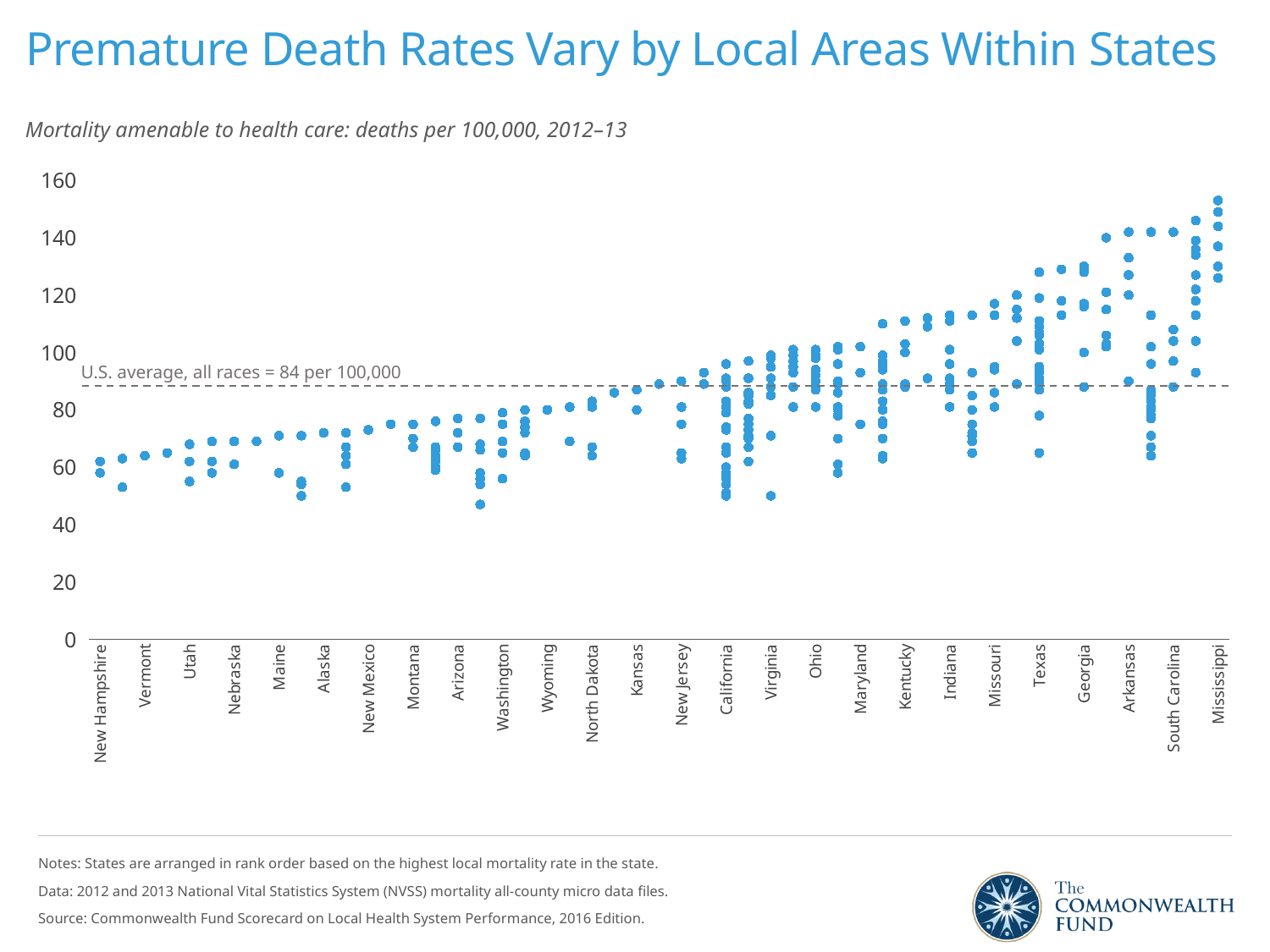
Are all of the New Hampshire points greater or less than 80? less What is the maximum value shown on the y axis of the chart? 160 Is the highest value for Mississippi greater or less than 140? greater How many states are listed along the x axis of the chart? 26 What is the U.S. average mortality rate, all races, shown by the dashed line on the chart? 84 per 100,000 Which state is listed first (leftmost) on the x axis? New Hampshire What kind of chart is shown on the slide? Scatter (dot) plot According to the notes, how are the states arranged on the chart? In rank order based on the highest local mortality rate in the state Which state has the larger highest local value, Georgia or Mississippi? Mississippi Do the highest local mortality rates generally rise or fall moving from left to right along the x axis? rise Which state has the highest local mortality rate on the chart? Mississippi Is the highest value for Texas greater or less than 120? greater